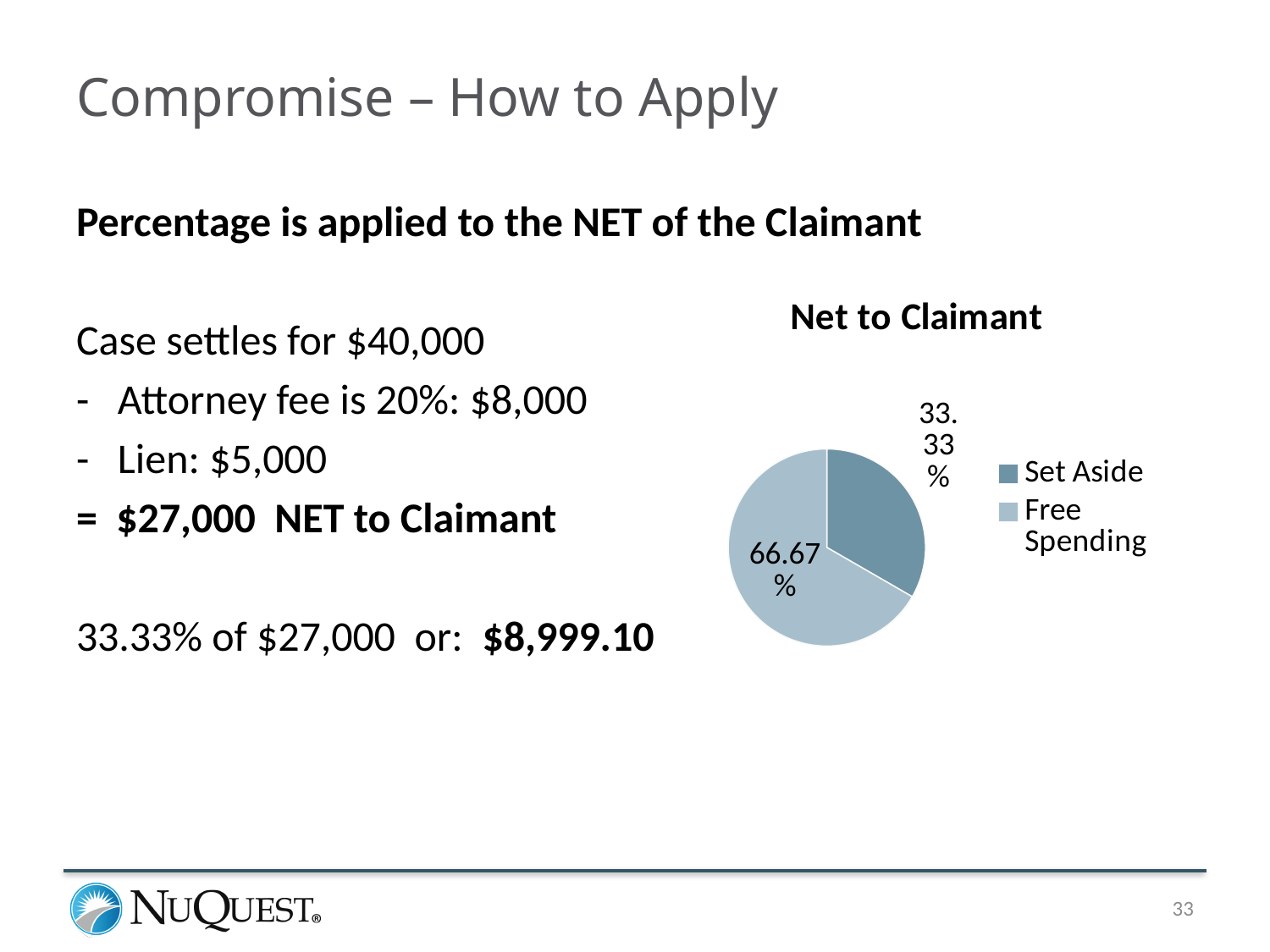
Which slice of the pie is the smallest? Set Aside Which is larger, the Set Aside slice or the Free Spending slice? Free Spending How many entries does the legend list? 2 What kind of chart is shown on the slide? pie chart Which legend entry is shown in the darker blue colour? Set Aside Which slice of the pie is the largest? Free Spending What is the difference in percentage points between the Free Spending and Set Aside slices? 33.34 What is the title of the chart? Net to Claimant What share of the pie does Set Aside represent? 33.33% What share of the pie does Free Spending represent? 66.67% How many slices does the pie chart have? 2